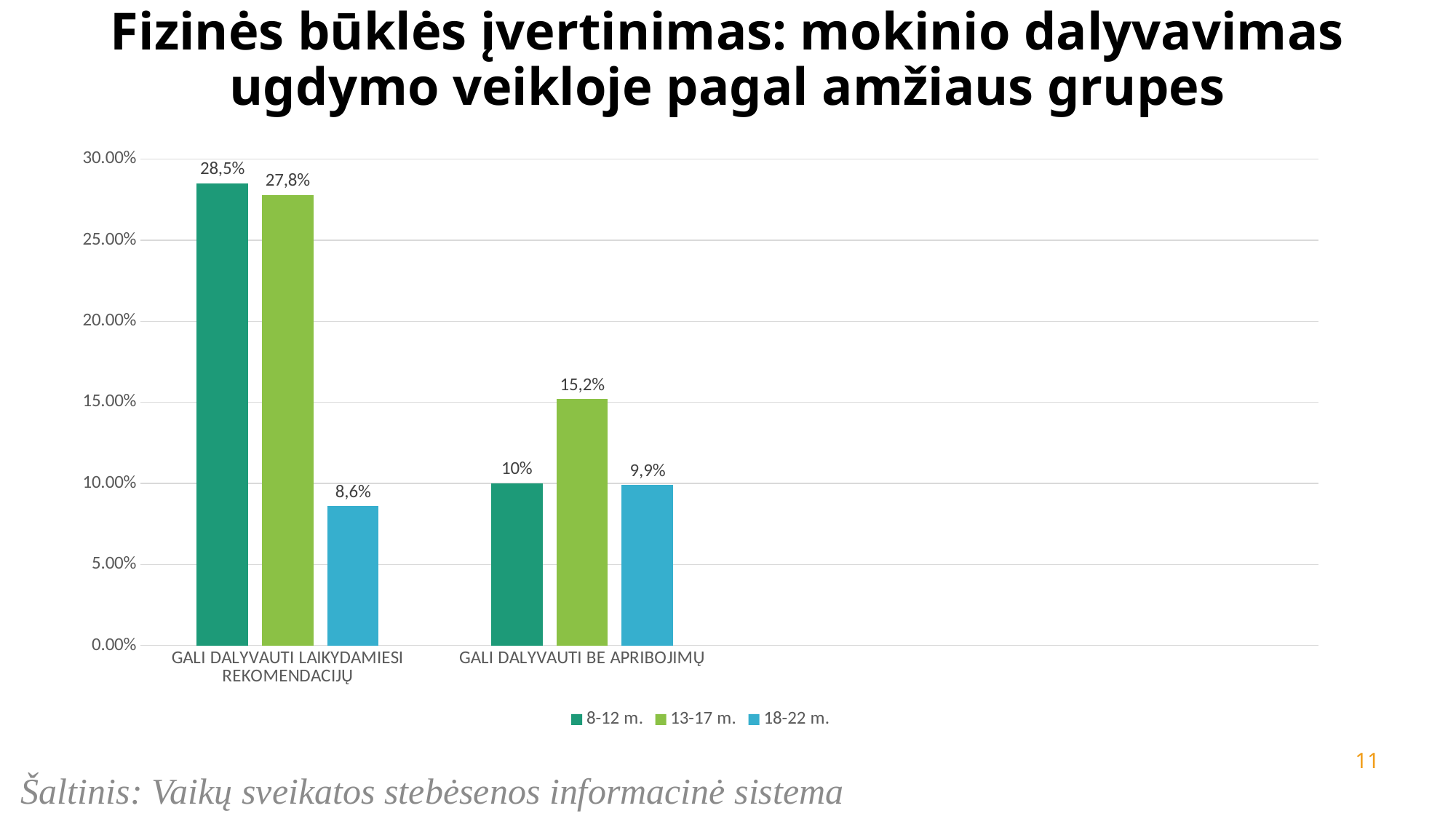
What is the value for the 13-17 m. series in the 'Gali dalyvauti be apribojimų' category? 15,2% What is the value for the 18-22 m. series in the 'Gali dalyvauti laikydamiesi rekomendacijų' category? 8,6% How many series does the legend list? 3 Which series has the lowest value in the 'Gali dalyvauti laikydamiesi rekomendacijų' category? 18-22 m. What is the value for the 8-12 m. series in the 'Gali dalyvauti laikydamiesi rekomendacijų' category? 28,5% What is the difference between the 8-12 m. and 18-22 m. values in the 'Gali dalyvauti laikydamiesi rekomendacijų' category? 19,9% Is the value for 18-22 m. in the 'Gali dalyvauti be apribojimų' category greater or less than 10.00%? less Which is larger: the 13-17 m. value for 'Gali dalyvauti laikydamiesi rekomendacijų' or the 13-17 m. value for 'Gali dalyvauti be apribojimų'? Gali dalyvauti laikydamiesi rekomendacijų What is the value for the 8-12 m. series in the 'Gali dalyvauti be apribojimų' category? 10% Which series has the highest value in the 'Gali dalyvauti be apribojimų' category? 13-17 m. How many categories are shown on the x axis? 2 What kind of chart is shown on the slide? Bar chart